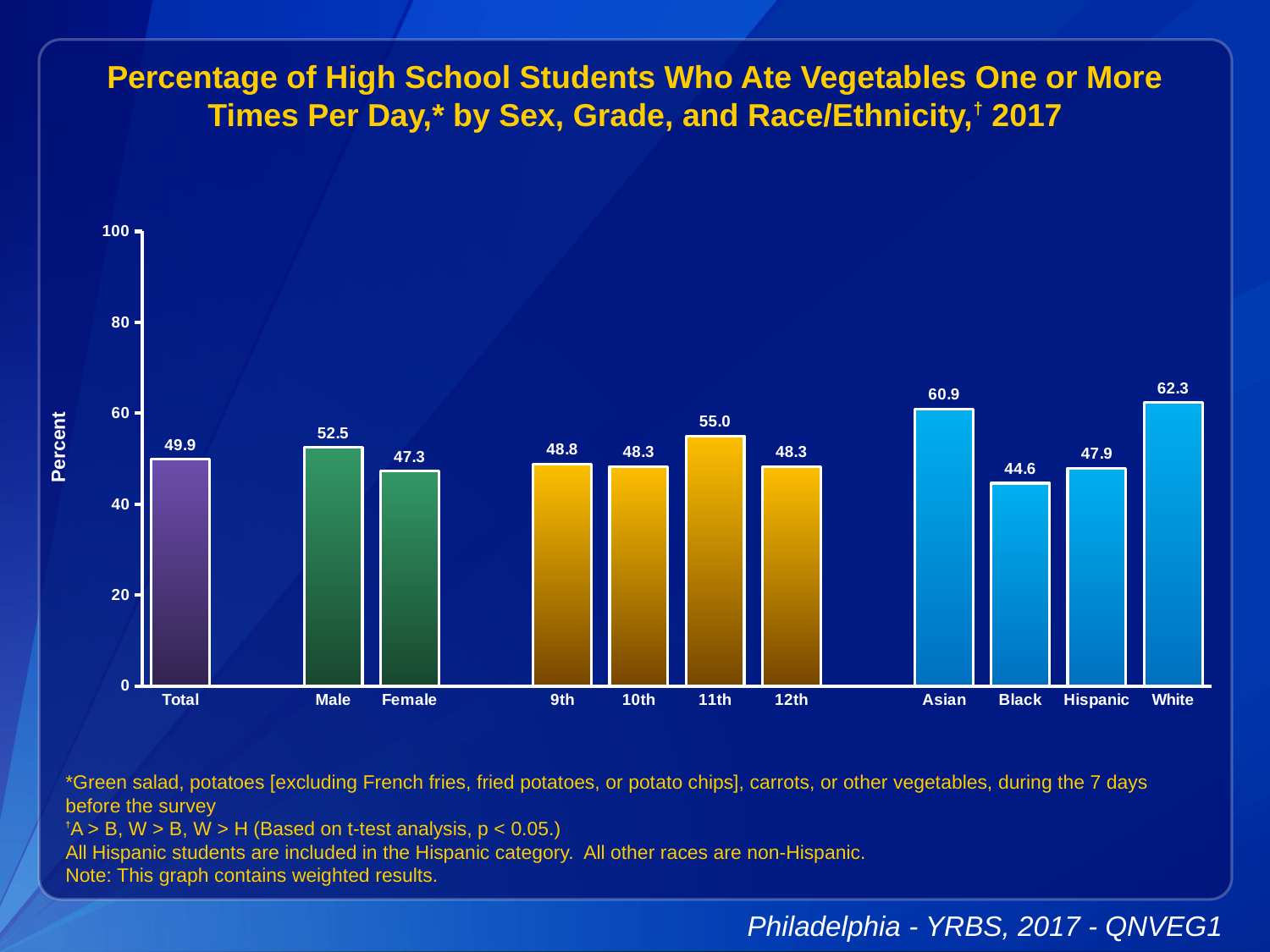
Which category has the highest value? White Which category has the lowest value? Black How many bars are shown in the chart? 11 What is the value for 11th grade? 55.0 What kind of chart is shown on the slide? bar chart What is the difference between the values for Male and Female? 5.2 What is the value for Female? 47.3 What is the value for Total? 49.9 Is the value for 9th grade greater or less than 60? less Which is larger, the value for Asian or the value for Hispanic? Asian What is the value for Black students? 44.6 What is the label on the y axis? Percent